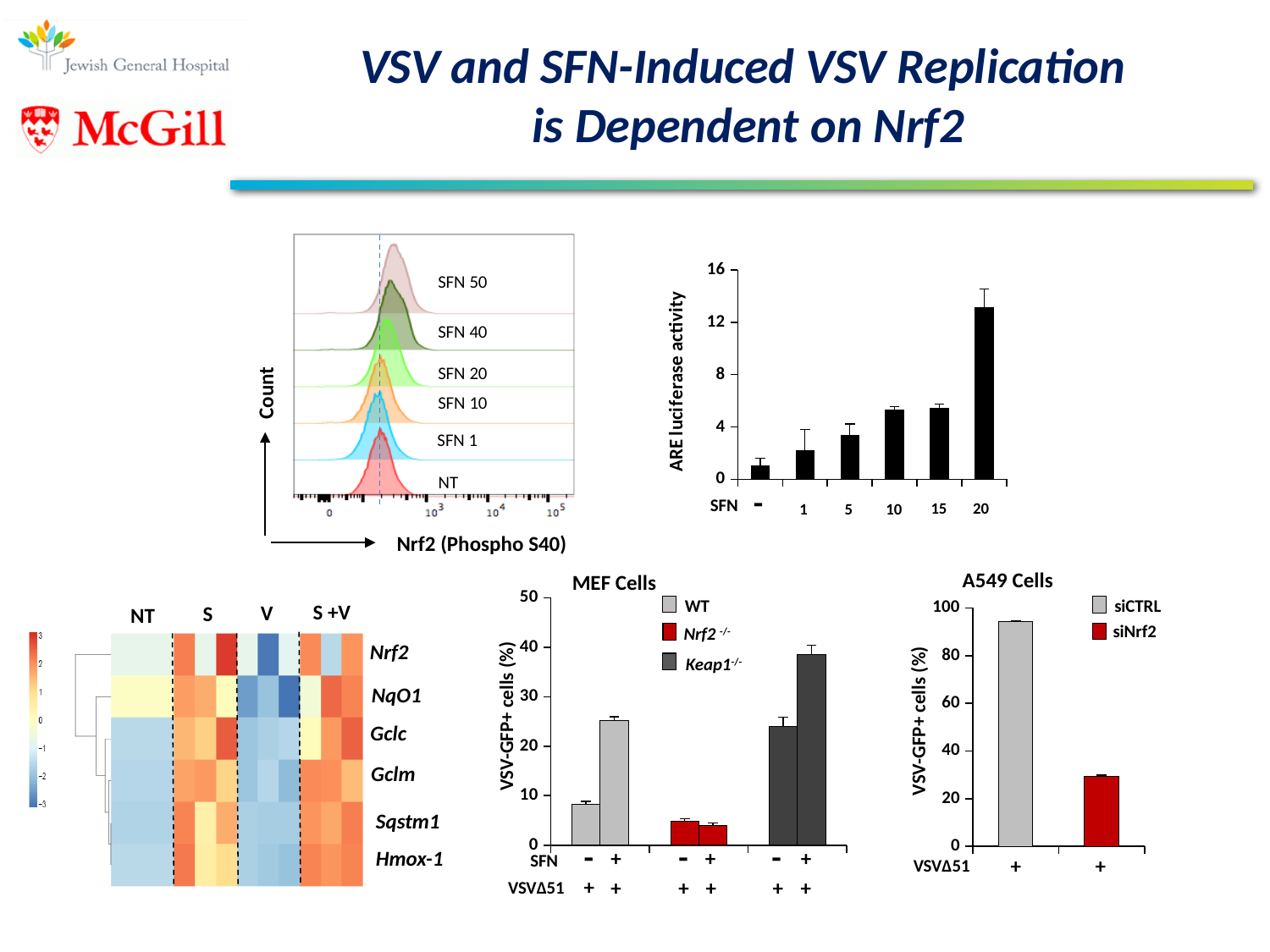
In the ARE luciferase activity chart (top right), which condition has the lowest activity? - (no SFN) In the MEF Cells chart, which series has the highest VSV-GFP+ cells (%) bar? Keap1-/- In the ARE luciferase activity chart (top right), which SFN concentration gives the highest activity? 20 In the A549 Cells chart, is the value for siNrf2 greater or less than 40? less In the ARE luciferase activity chart (top right), is the value for SFN 5 greater or less than 4? less What kind of chart is the A549 Cells chart? bar chart In the MEF Cells chart, how many series does the legend list? 3 In the MEF Cells chart, is the value for WT with SFN + greater or less than 20? greater In the A549 Cells chart, which is larger, siCTRL or siNrf2? siCTRL In the ARE luciferase activity chart (top right), does ARE luciferase activity rise or fall as the SFN concentration increases along the x axis? rise In the ARE luciferase activity chart (top right), how many bars are plotted? 6